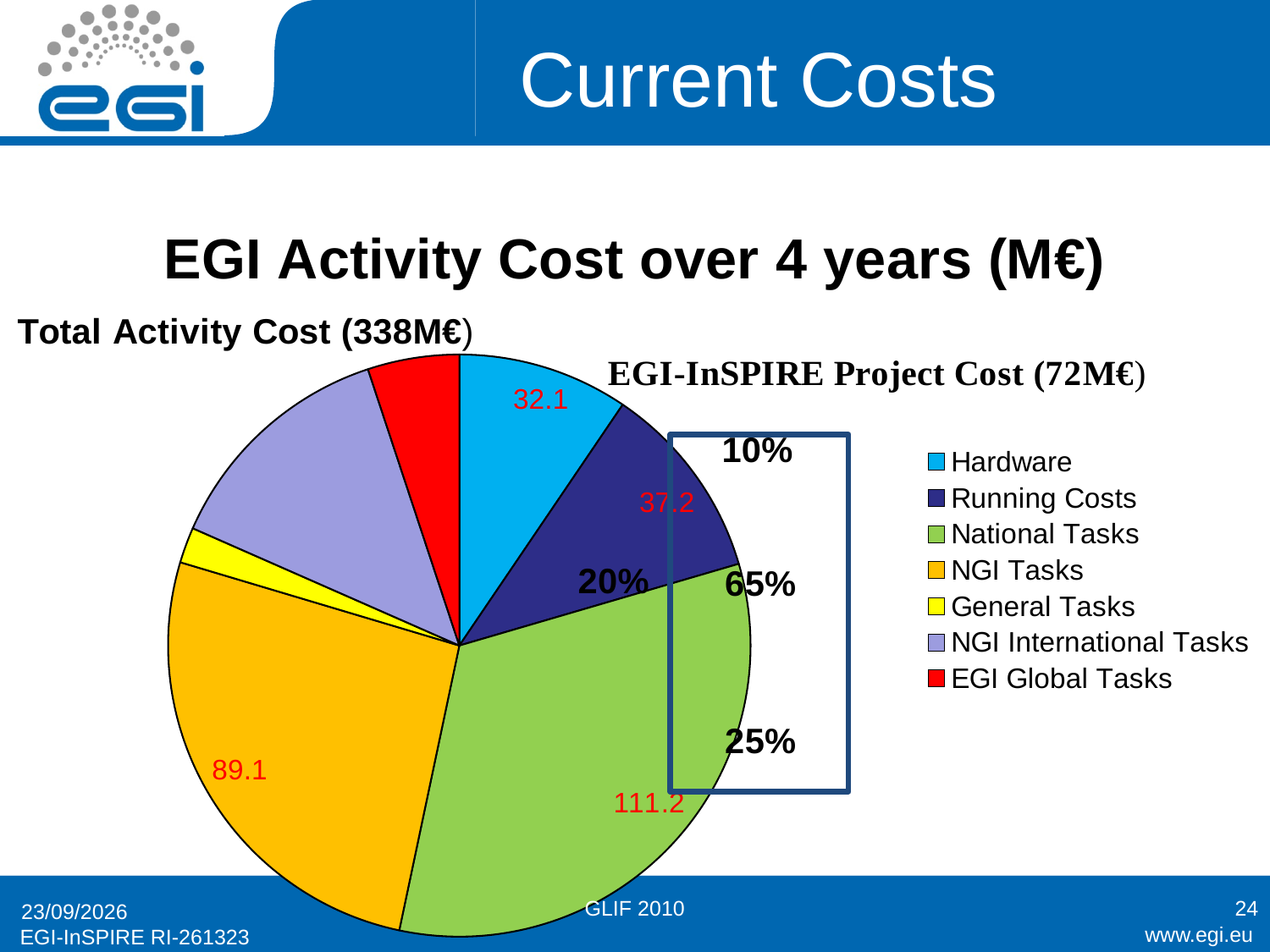
What is the value shown for Hardware in the pie chart? 32.1 What is the difference between the values for National Tasks and NGI Tasks? 22.1 What is the title of the chart? EGI Activity Cost over 4 years (M€) What kind of chart is shown on the slide? Pie chart What is the difference between the values for Running Costs and Hardware? 5.1 How many categories does the pie chart's legend list? 7 Which category has the largest slice of the pie chart? National Tasks Which category has the smallest slice of the pie chart? General Tasks Which is larger, the value for Hardware or the value for Running Costs? Running Costs What is the value shown for Running Costs in the pie chart? 37.2 What is the value shown for NGI Tasks in the pie chart? 89.1 What is the value shown for National Tasks in the pie chart? 111.2